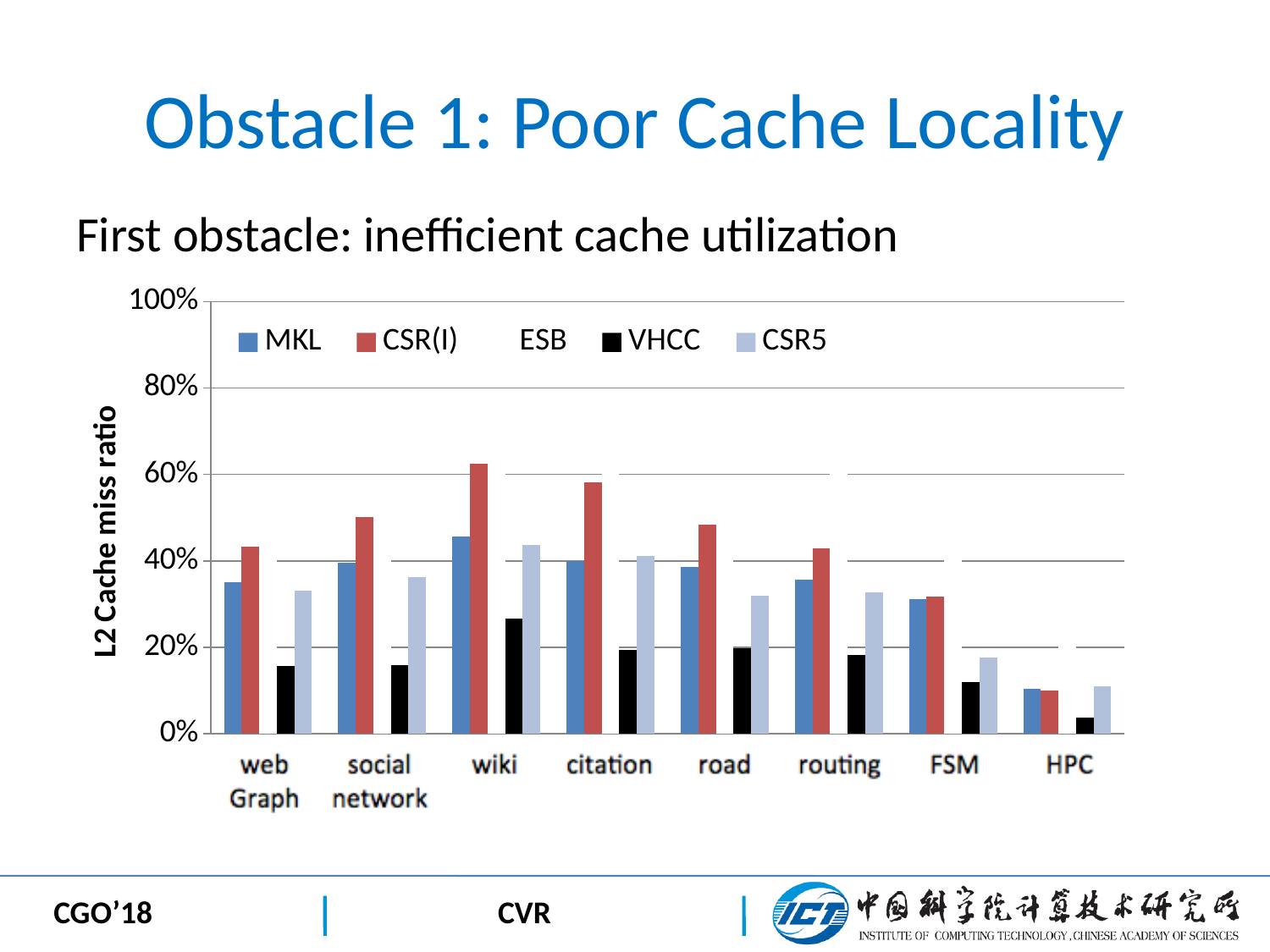
Is the CSR5 value for HPC greater or less than 20%? less Is the CSR(I) value for citation greater or less than 40%? greater How many categories are shown along the x axis of the chart? 8 What colour are the VHCC bars in the chart? black Is the VHCC value for web Graph greater or less than 20%? less For social network, which is larger: the CSR(I) value or the CSR5 value? CSR(I) How many series does the chart's legend list? 5 What kind of chart is shown on the slide? bar chart For wiki, which is larger: the MKL value or the VHCC value? MKL For which category is the CSR(I) bar the highest? wiki For which category is the VHCC bar the lowest? HPC What is the label of the chart's y axis? L2 Cache miss ratio